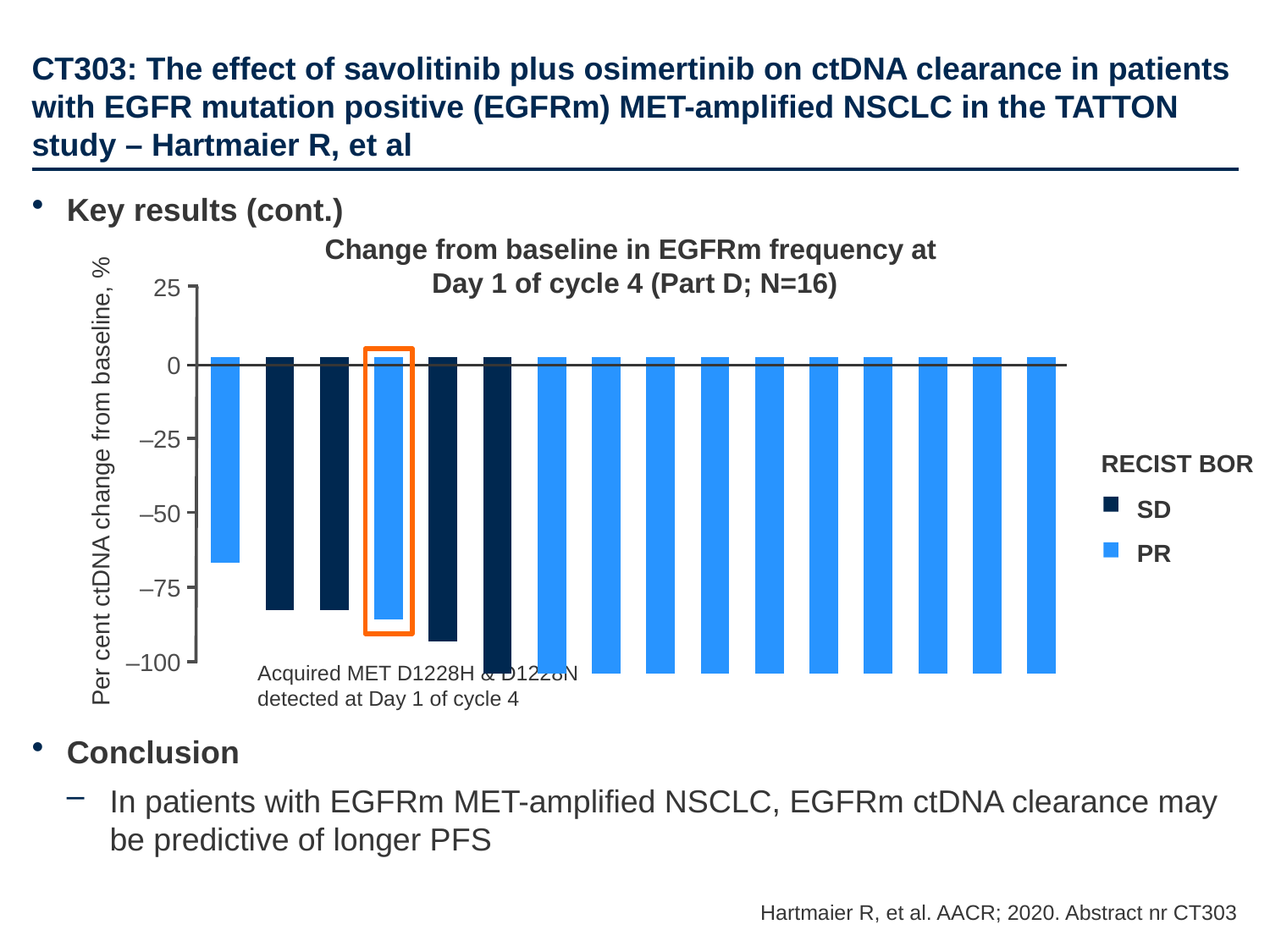
Is the value of the second bar from the left greater or less than −75? less Is the value of the leftmost bar greater or less than −50? less What are the two entries in the chart legend? SD and PR Is the value of the leftmost bar greater or less than −75? greater What kind of chart is shown on the slide? Bar chart How many bars in the chart are coloured dark blue (SD)? 4 How many bars are plotted in the chart? 16 Which bar has the highest value (the smallest decrease from baseline)? The leftmost bar Do the bar values generally rise or fall moving from left to right across the chart? fall What is the title of the chart? Change from baseline in EGFRm frequency at Day 1 of cycle 4 (Part D; N=16) How many bars in the chart are coloured light blue (PR)? 12 How many series does the legend list? 2